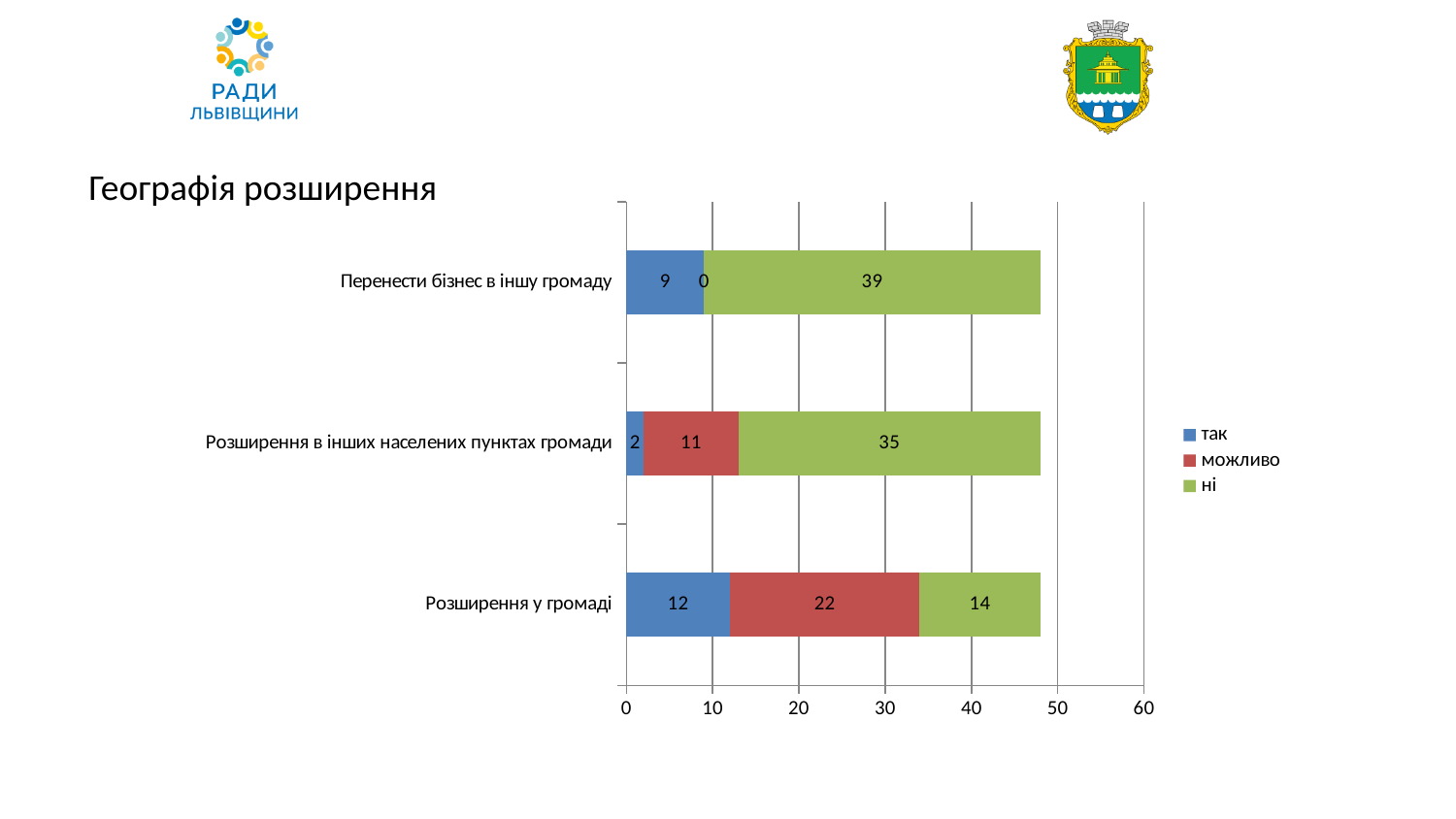
What is the difference between the "ні" values for "Перенести бізнес в іншу громаду" and "Розширення в інших населених пунктах громади"? 4 How many series does the legend list? 3 How many categories are shown on the chart? 3 What is the value of "так" for "Розширення в інших населених пунктах громади"? 2 Which is larger: the "можливо" value for "Розширення у громаді" or the "можливо" value for "Розширення в інших населених пунктах громади"? Розширення у громаді What is the value of "ні" for "Перенести бізнес в іншу громаду"? 39 What is the total of the stacked bar for "Розширення у громаді"? 48 Which category has the lowest value for "ні"? Розширення у громаді Which category has the highest value for "так"? Розширення у громаді What type of chart is shown on the slide? stacked bar chart What is the value of "можливо" for "Розширення у громаді"? 22 What is the value of "можливо" for "Перенести бізнес в іншу громаду"? 0